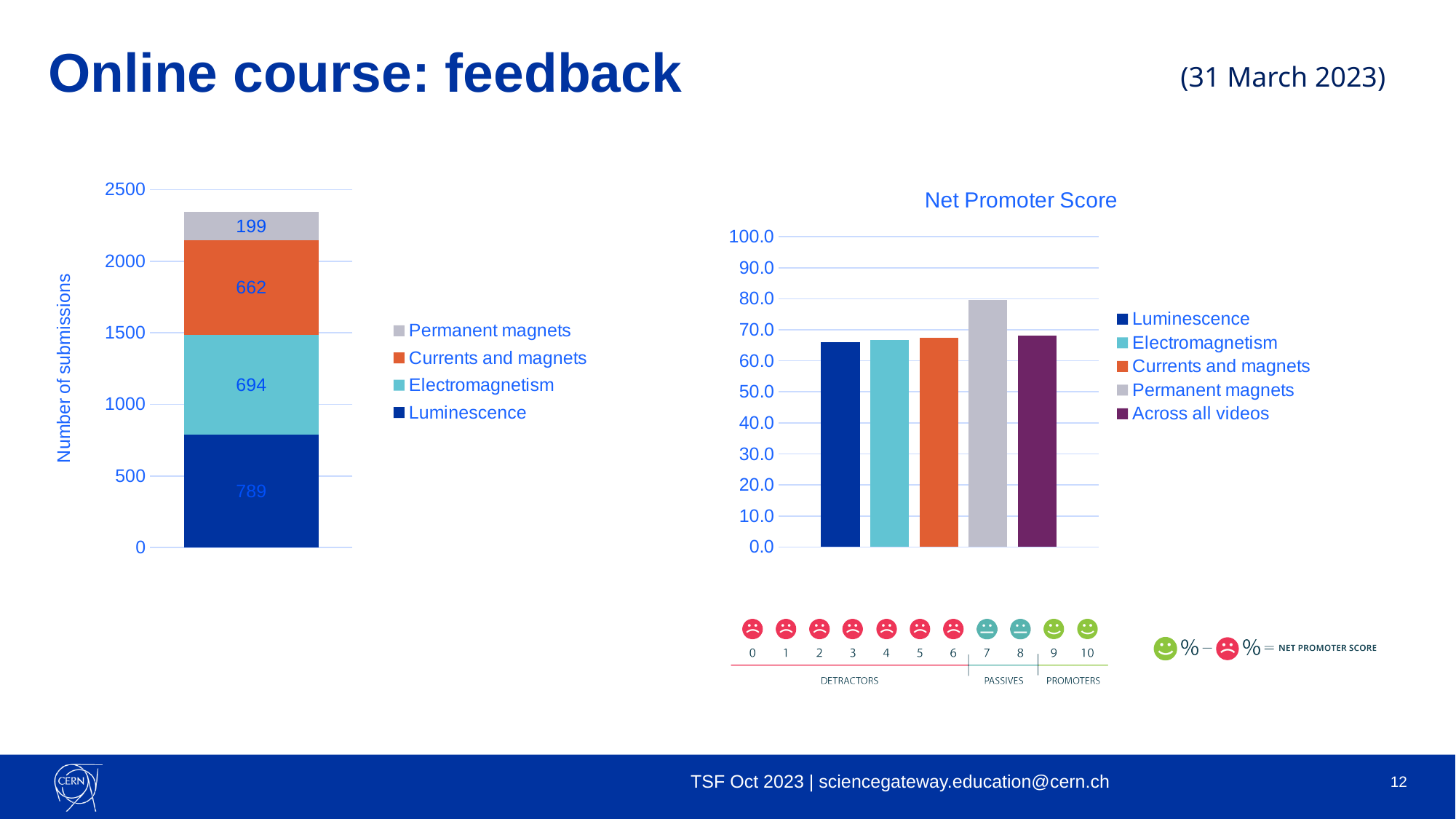
On the Net Promoter Score chart, which video has the highest score? Permanent magnets On the left chart (Number of submissions), how many submissions are shown for Luminescence? 789 On the left chart (Number of submissions), how many submissions are shown for Permanent magnets? 199 On the left chart (Number of submissions), how many series does the legend list? 4 On the left chart (Number of submissions), what is the total number of submissions across all four segments of the stacked bar? 2344 On the Net Promoter Score chart, is the value for Luminescence greater or less than 70.0? less On the left chart (Number of submissions), what is the difference between the Luminescence and Permanent magnets submissions? 590 On the left chart (Number of submissions), how many submissions are shown for Currents and magnets? 662 On the left chart (Number of submissions), which segment has the fewest submissions? Permanent magnets On the Net Promoter Score chart, is the value for Permanent magnets greater or less than 70.0? greater What kind of chart is the Net Promoter Score chart? Bar chart On the left chart (Number of submissions), how many submissions are shown for Electromagnetism? 694